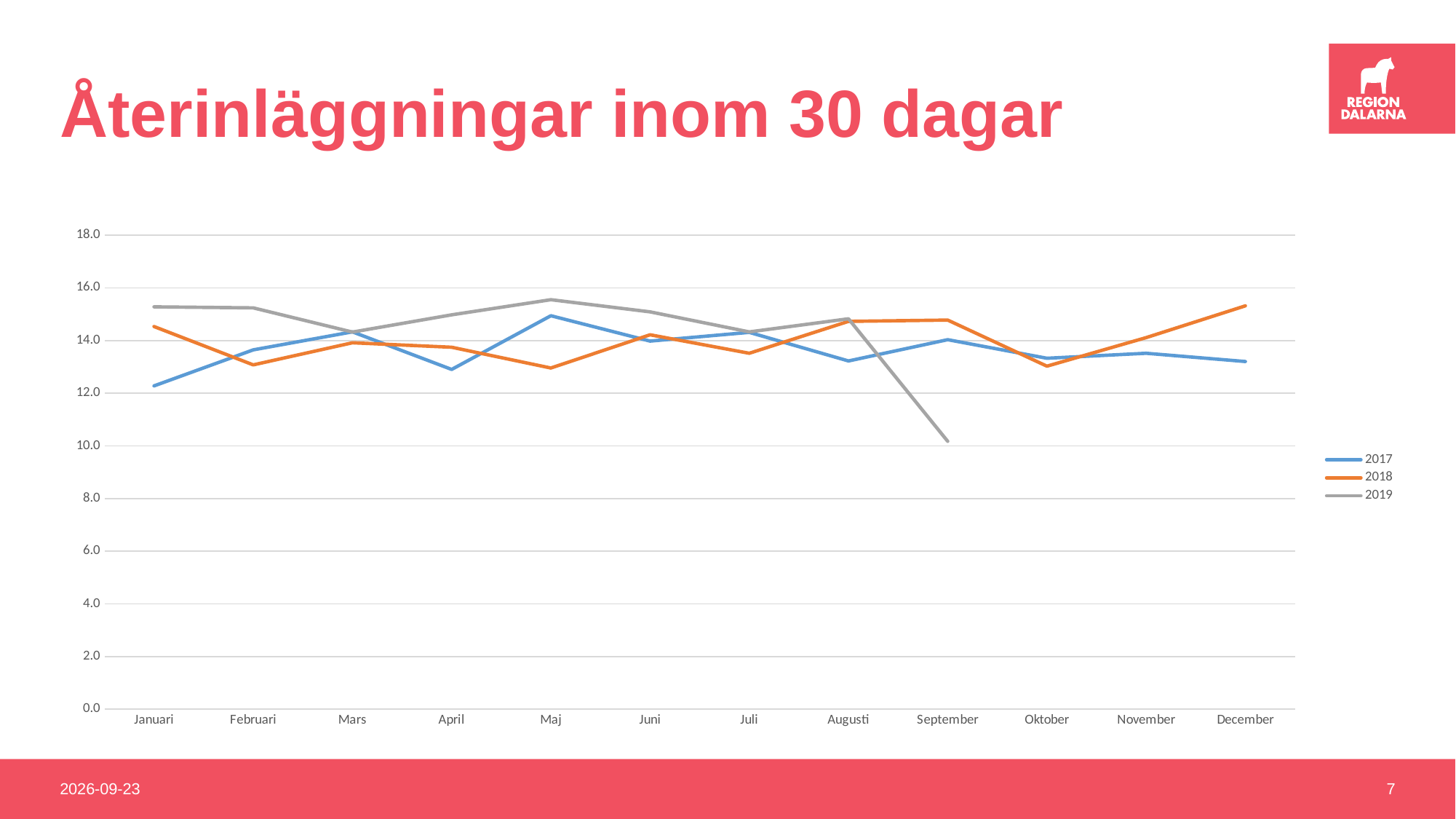
Is the value for 2019 in September greater or less than 12.0? less Does the 2019 series rise or fall from Augusti to September? Fall In Januari, which series has the higher value, 2017 or 2019? 2019 What kind of chart is shown on the slide? Line chart What is the title of the chart? Återinläggningar inom 30 dagar Is the value for 2017 in Januari greater or less than 14.0? less Is the value for 2018 in December greater or less than 14.0? greater Which years are listed in the legend? 2017, 2018, 2019 In September, which series has the higher value, 2017 or 2019? 2017 How many months are shown along the x axis? 12 In which month does the 2019 series reach its lowest value? September How many series does the legend list? 3